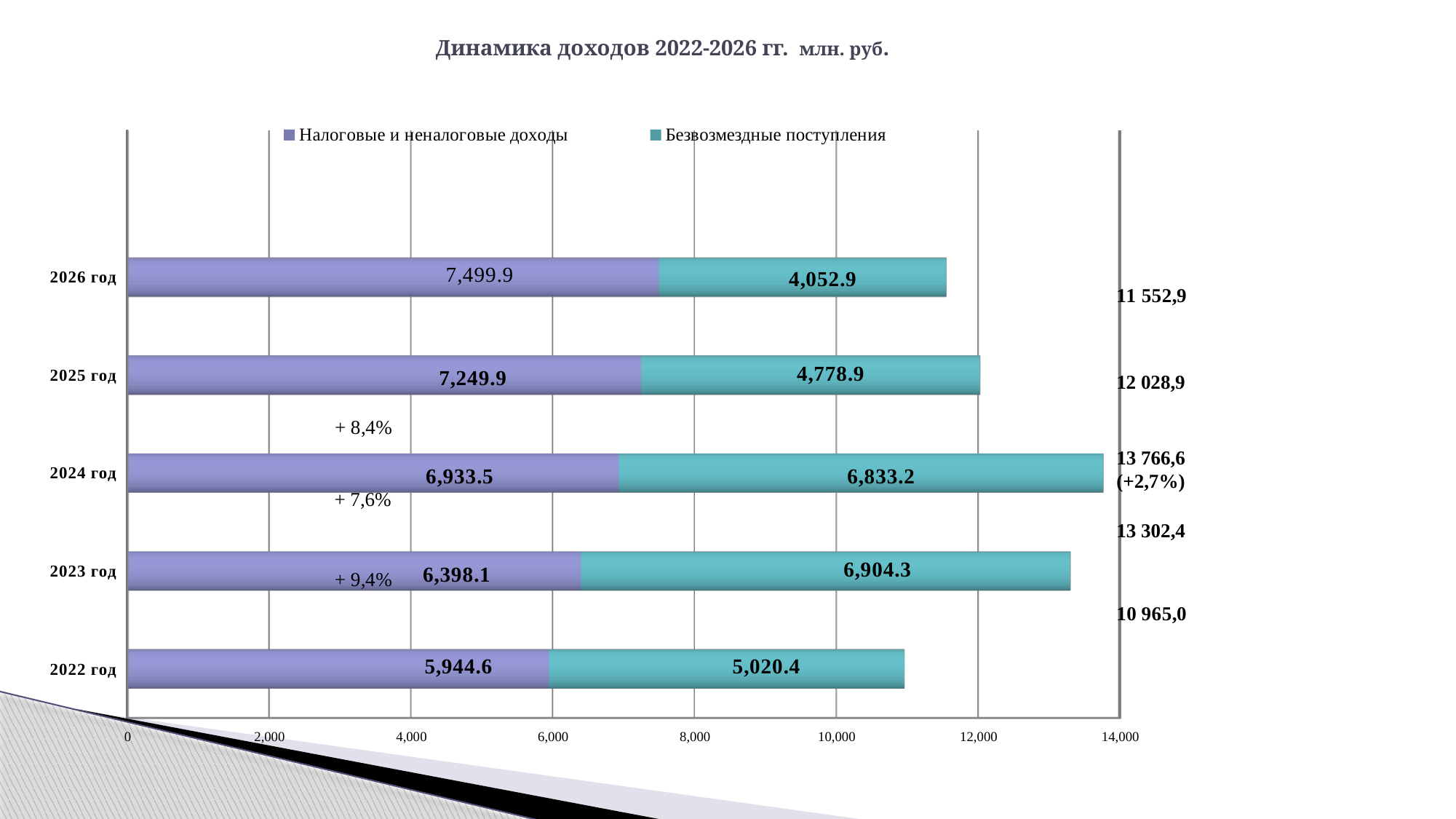
How many series does the legend list? 2 Which year has the highest value of Налоговые и неналоговые доходы? 2026 год Which is larger in 2024 год: Налоговые и неналоговые доходы or Безвозмездные поступления? Налоговые и неналоговые доходы What is the value of Безвозмездные поступления for 2023 год? 6,904.3 What is the value of Безвозмездные поступления for 2022 год? 5,020.4 What is the total of the stacked bar for 2022 год? 10 965,0 What is the total of the stacked bar for 2024 год? 13 766,6 What is the difference between Налоговые и неналоговые доходы in 2025 год and 2024 год? 316.4 What type of chart is shown on the slide? Stacked bar chart Which year has the lowest value of Безвозмездные поступления? 2026 год How many years are shown on the chart? 5 What is the value of Налоговые и неналоговые доходы for 2026 год? 7,499.9